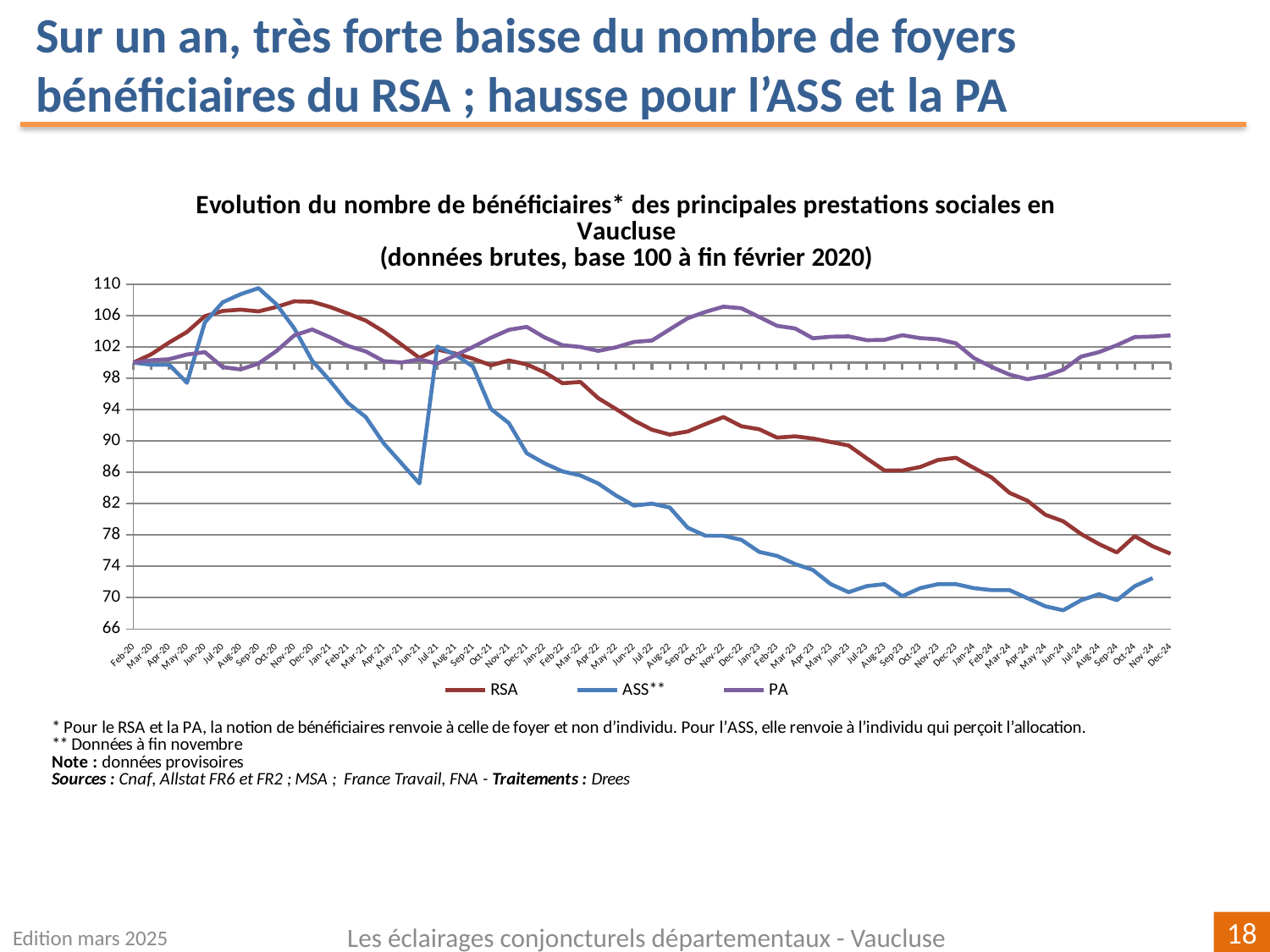
What are the three series named in the legend? RSA, ASS**, PA Does the ASS** series rise or fall overall from Feb-20 to Dec-24? fall Is the value for ASS** at Jun-24 greater or less than 70? less Which series has the lowest value at Dec-24? RSA Is the value for RSA at Dec-24 greater or less than 78? less What kind of chart is shown on the slide? line chart Does the RSA series rise or fall overall from Feb-20 to Dec-24? fall What colour is the line for the RSA series? dark red Is the value for ASS** at Sep-20 greater or less than 106? greater How many series does the legend list? 3 Which series has the highest value at Dec-24? PA